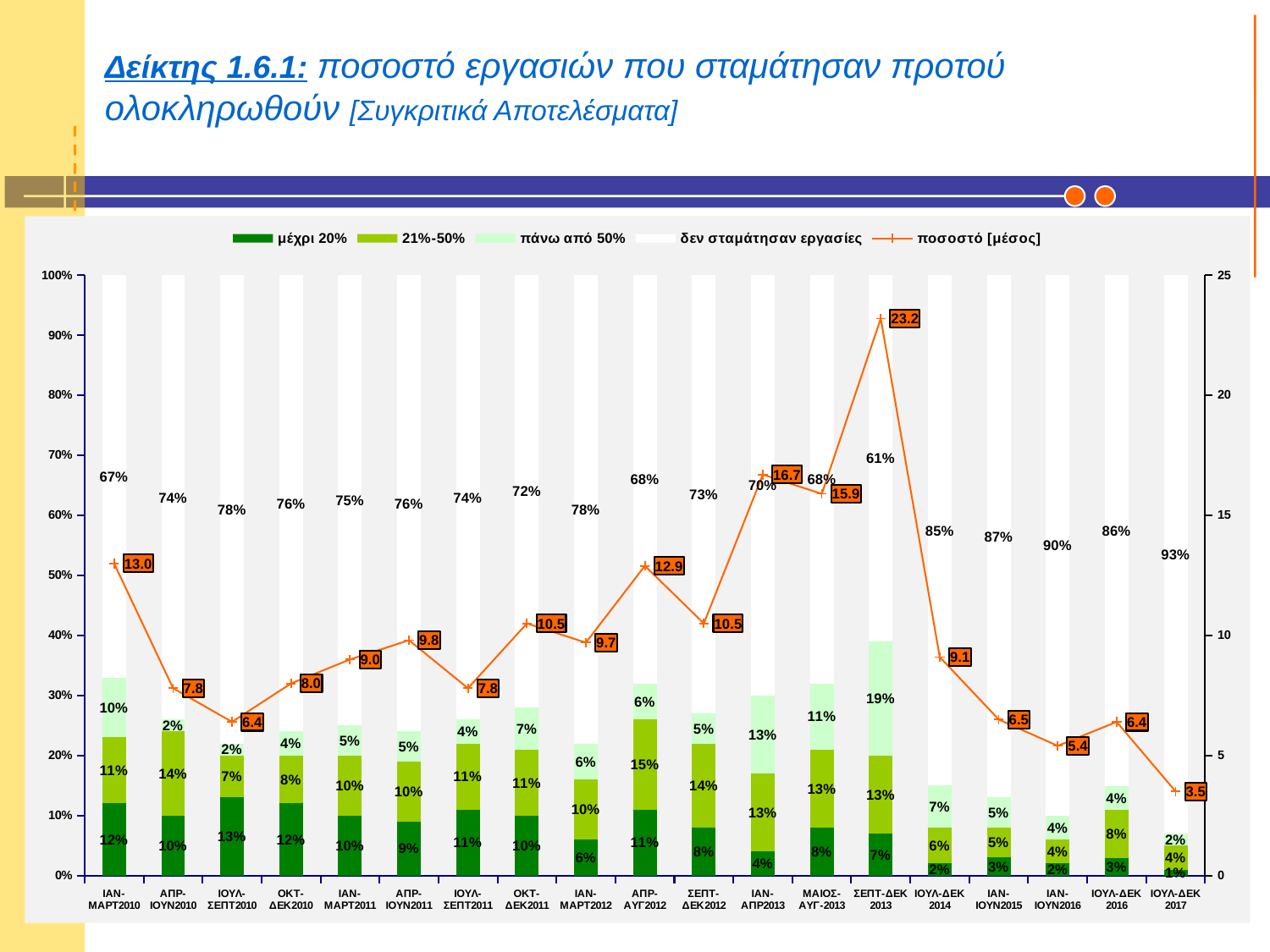
What is the μέχρι 20% value for ΙΑΝ-ΜΑΡΤ2010? 12% How many periods are shown on the x axis? 19 What is the value of the ποσοστό [μέσος] line for ΣΕΠΤ-ΔΕΚ 2013? 23.2 What kind of chart is shown on the slide? Combined stacked bar and line chart What is the πάνω από 50% value for ΣΕΠΤ-ΔΕΚ 2013? 19% Which has the larger ποσοστό [μέσος] value, ΙΑΝ-ΑΠΡ2013 or ΜΑΙΟΣ-ΑΥΓ-2013? ΙΑΝ-ΑΠΡ2013 What is the difference between the ποσοστό [μέσος] values for ΣΕΠΤ-ΔΕΚ 2013 and ΙΑΝ-ΑΠΡ2013? 6.5 Which period has the lowest value on the ποσοστό [μέσος] line? ΙΟΥΛ-ΔΕΚ 2017 How many series does the legend list? 5 Which period has the highest value on the ποσοστό [μέσος] line? ΣΕΠΤ-ΔΕΚ 2013 What is the δεν σταμάτησαν εργασίες percentage for ΙΟΥΛ-ΔΕΚ 2017? 93% Does the ποσοστό [μέσος] line rise or fall from ΣΕΠΤ-ΔΕΚ 2013 to ΙΟΥΛ-ΔΕΚ 2017? Fall